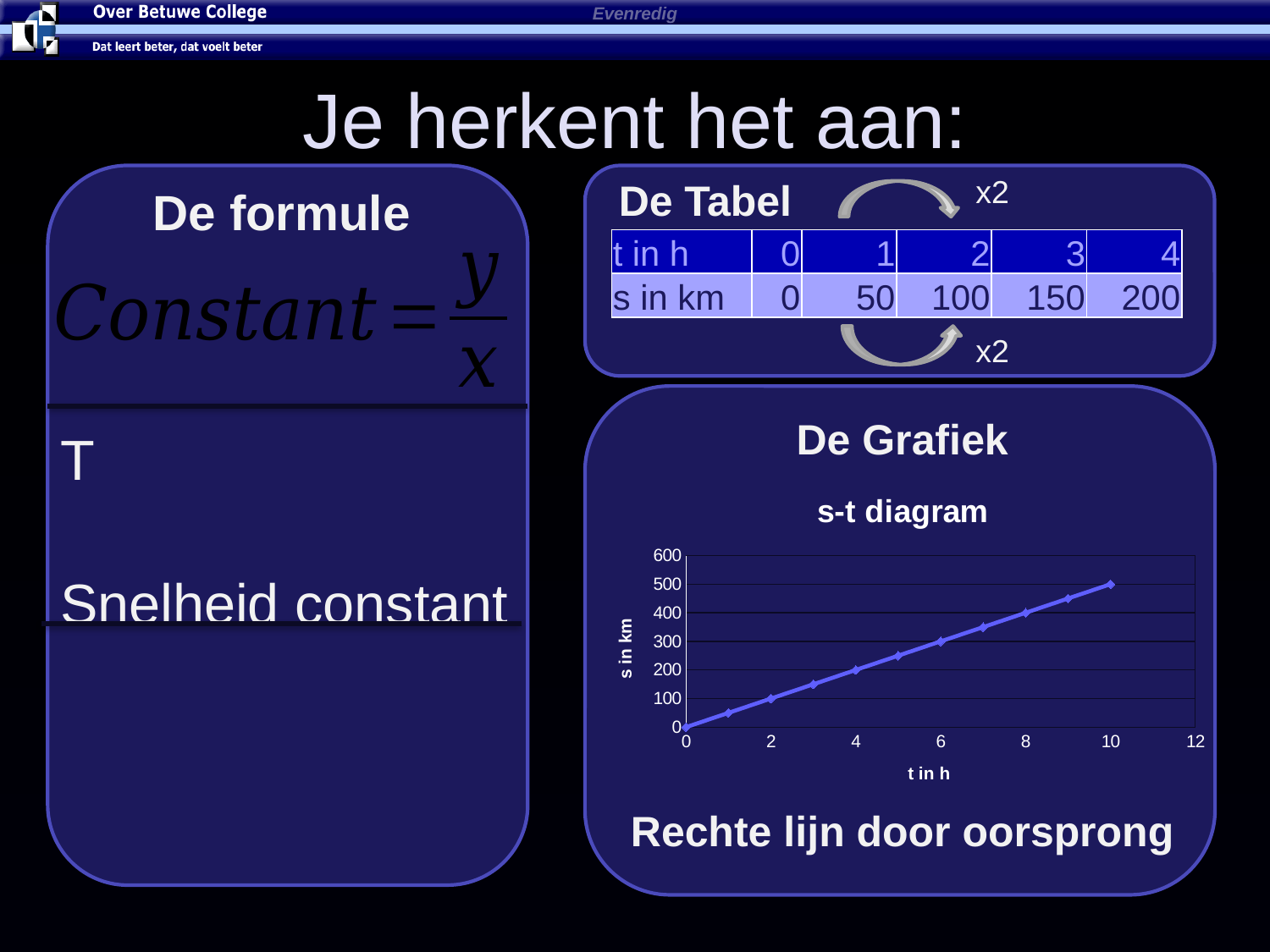
In the s-t diagram, do the values of s rise or fall as t increases? rise In the s-t diagram, what is the difference in s between t = 8 h and t = 2 h? 300 In the s-t diagram, at which value of t is s lowest? 0 How many data points are plotted in the s-t diagram? 11 What is the label of the vertical axis in the s-t diagram? s in km In the s-t diagram, is the value of s at t = 5 h greater or less than 200? greater In the s-t diagram, what is the value of s in km at t = 0 h? 0 In the s-t diagram, what is the value of s in km at t = 6 h? 300 In the s-t diagram, at which value of t is s highest? 10 In the s-t diagram, what is the value of s in km at t = 10 h? 500 What type of chart is the s-t diagram? line chart In the s-t diagram, what is the value of s in km at t = 4 h? 200